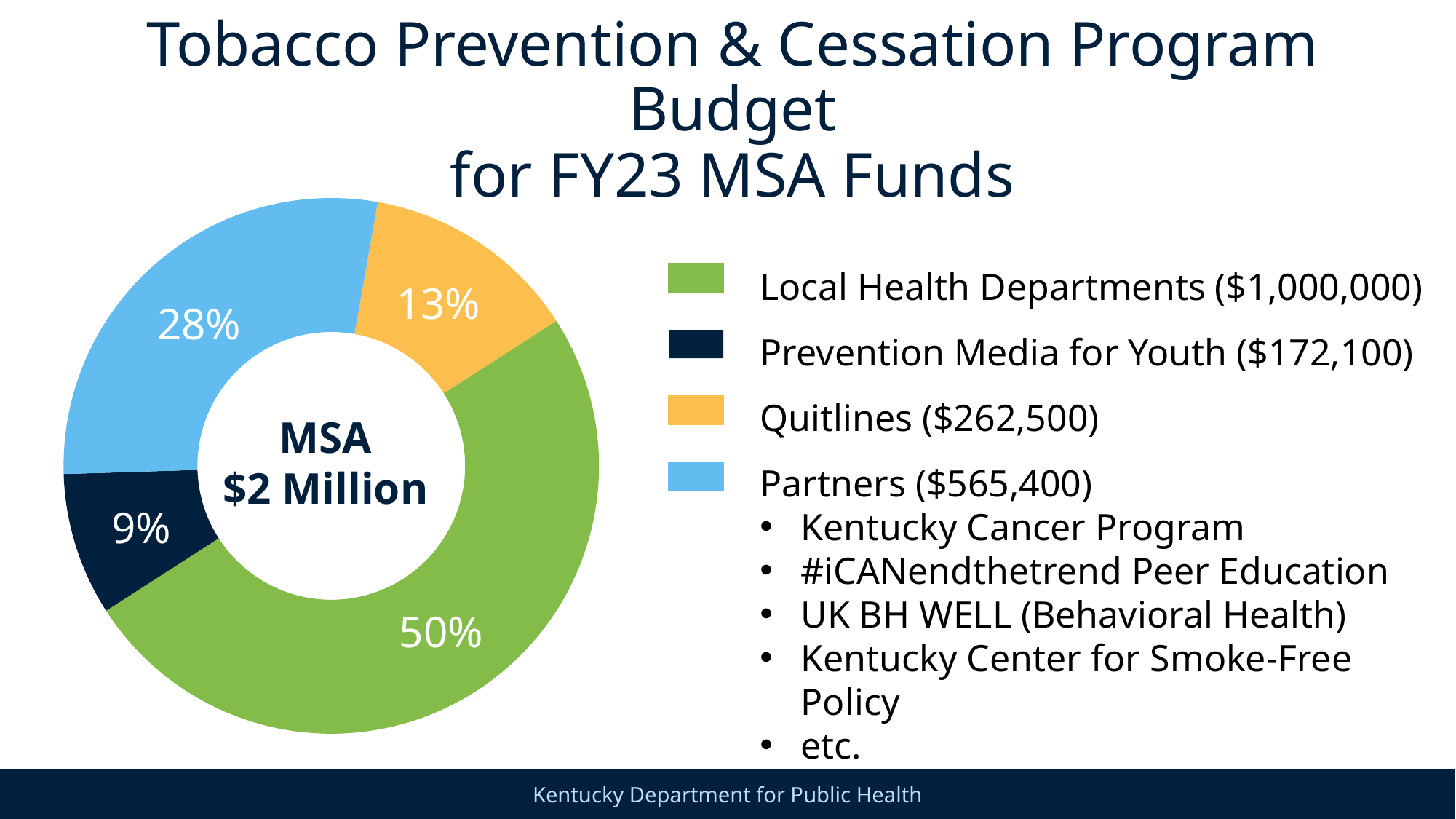
What share of the pie does Local Health Departments represent? 50% How many slices does the pie chart have? 4 What is the difference in percentage points between the Partners slice and the Quitlines slice? 15 What share of the pie does Prevention Media for Youth represent? 9% Which category has the largest slice of the pie? Local Health Departments What text is shown in the center of the pie chart? MSA $2 Million What dollar amount does the legend give for Quitlines? $262,500 What share of the pie does Quitlines represent? 13% Which slice is larger, Quitlines or Prevention Media for Youth? Quitlines What kind of chart is shown on the slide? Doughnut chart Which category has the smallest slice of the pie? Prevention Media for Youth